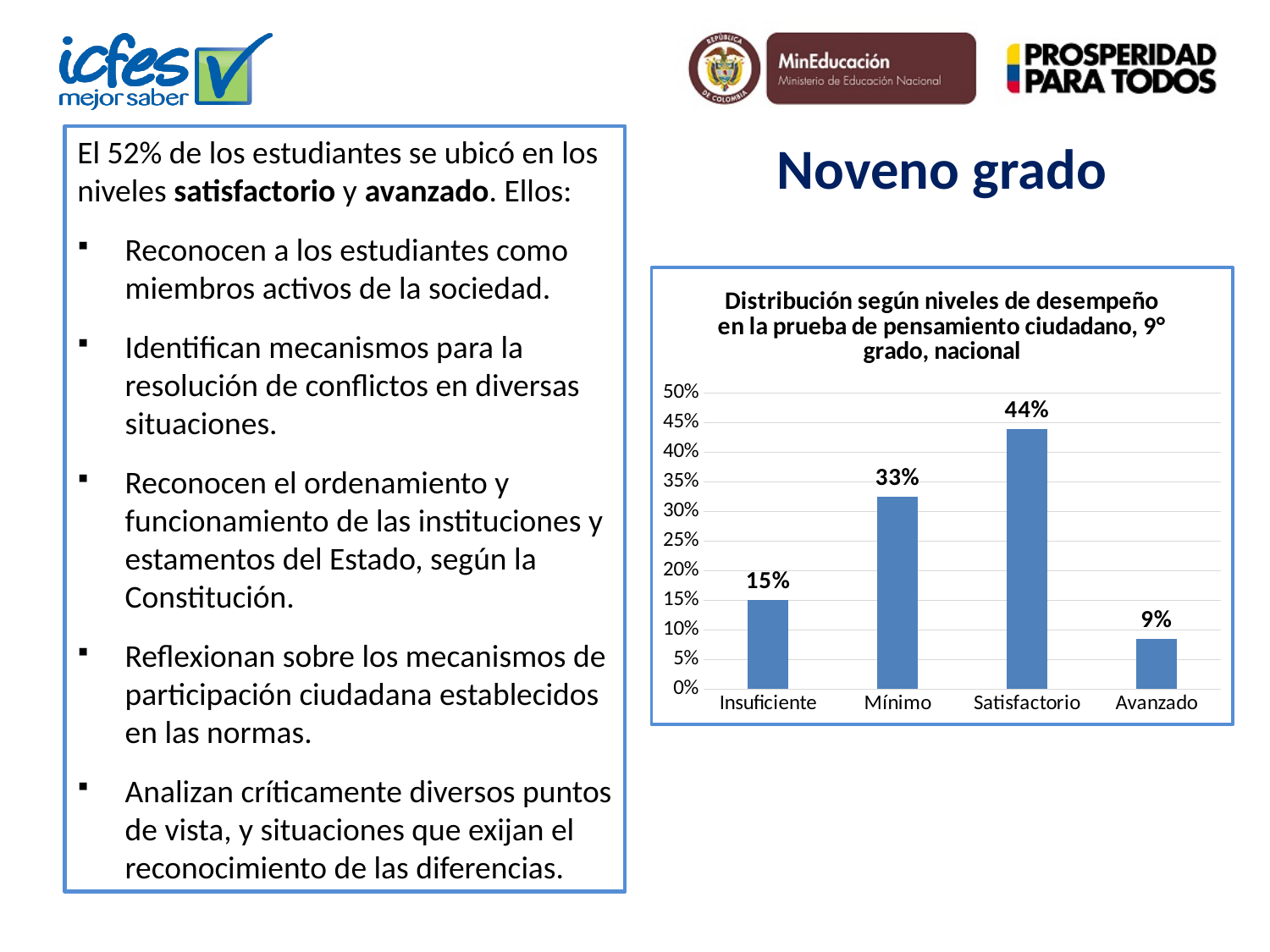
How many categories are shown on the x axis? 4 What is the value for Satisfactorio? 44% What is the value for Avanzado? 9% What is the value for Mínimo? 33% What is the value for Insuficiente? 15% Which category has the highest value? Satisfactorio What is the title of the chart? Distribución según niveles de desempeño en la prueba de pensamiento ciudadano, 9° grado, nacional What is the difference between the values for Satisfactorio and Mínimo? 11% Which category has the lowest value? Avanzado What kind of chart is shown? Bar chart What is the difference between the values for Insuficiente and Avanzado? 6% Which is larger, the value for Mínimo or the value for Insuficiente? Mínimo